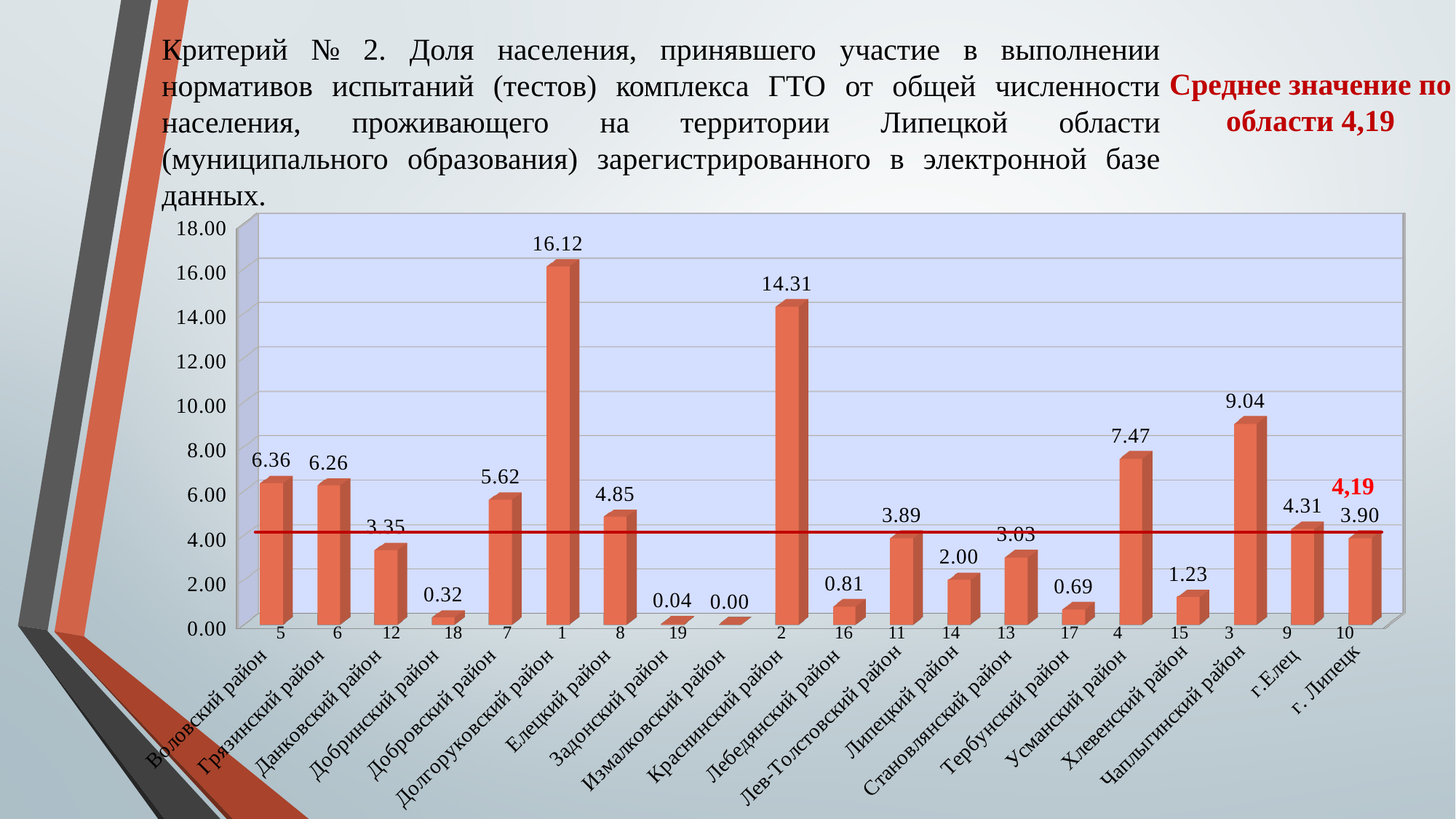
What is the difference between the values for Долгоруковский район and Краснинский район? 1.81 What kind of chart is shown on the slide? Bar chart What is the value for Краснинский район? 14.31 What is the difference between the values for г.Елец and г. Липецк? 0.41 What is the value for Долгоруковский район? 16.12 Which category has the highest value? Долгоруковский район How many categories are shown on the x axis? 20 What is the value for Чаплыгинский район? 9.04 What is the average value for the region marked by the red horizontal line? 4,19 Which is larger, the value for Усманский район or the value for Воловский район? Усманский район What is the value for г. Липецк? 3.90 Which category has the lowest value? Измалковский район